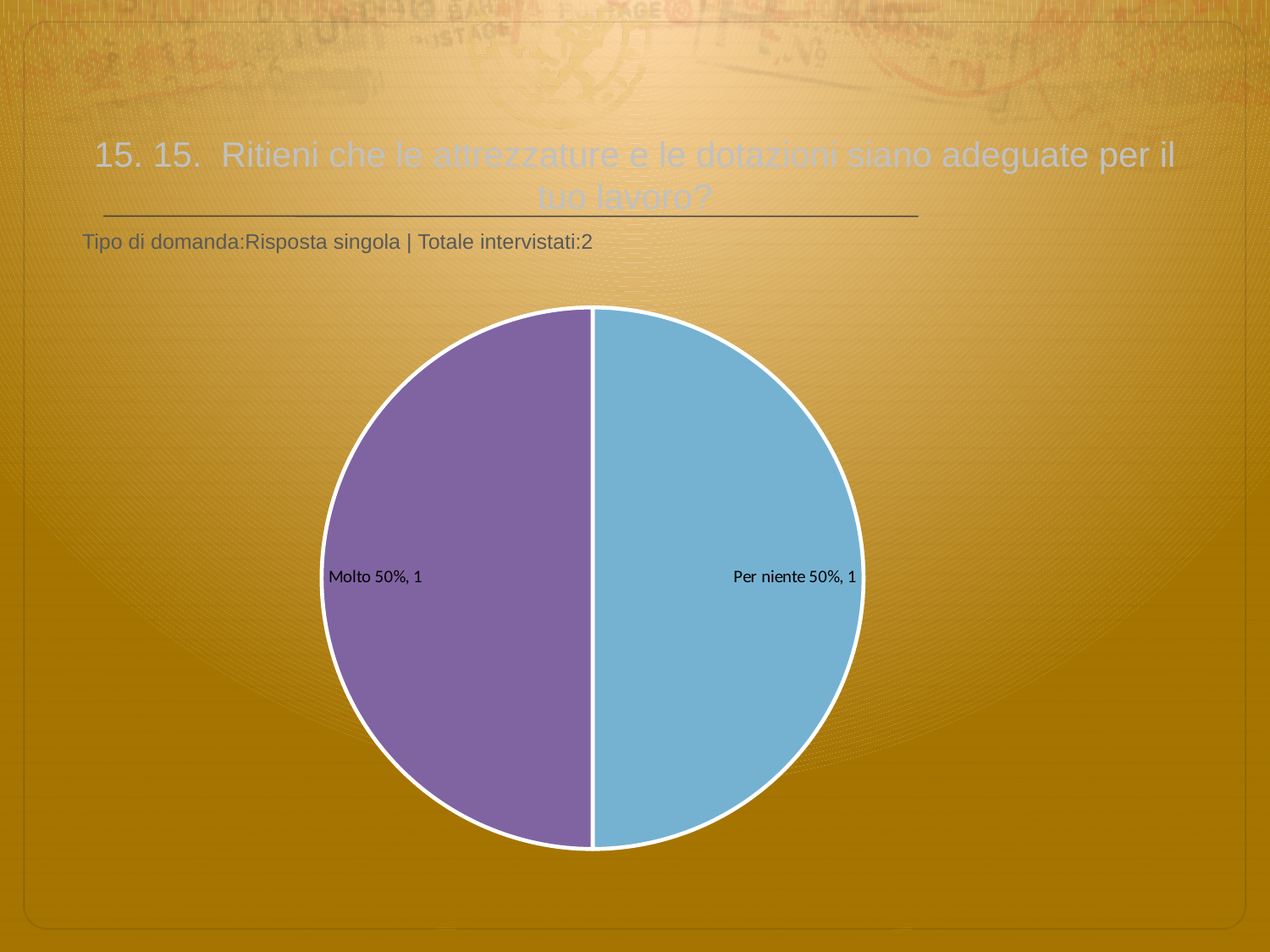
What is the total count across both slices of the pie chart? 2 What is the difference between the counts for "Molto" and "Per niente"? 0 What kind of chart is shown on the slide? pie chart What is the count value shown for the "Molto" slice? 1 Which slice of the pie chart is coloured light blue? Per niente What is the count value shown for the "Per niente" slice? 1 What percentage share does the "Molto" slice have? 50% What percentage share does the "Per niente" slice have? 50% How many slices does the pie chart have? 2 Which slice of the pie chart is coloured purple? Molto